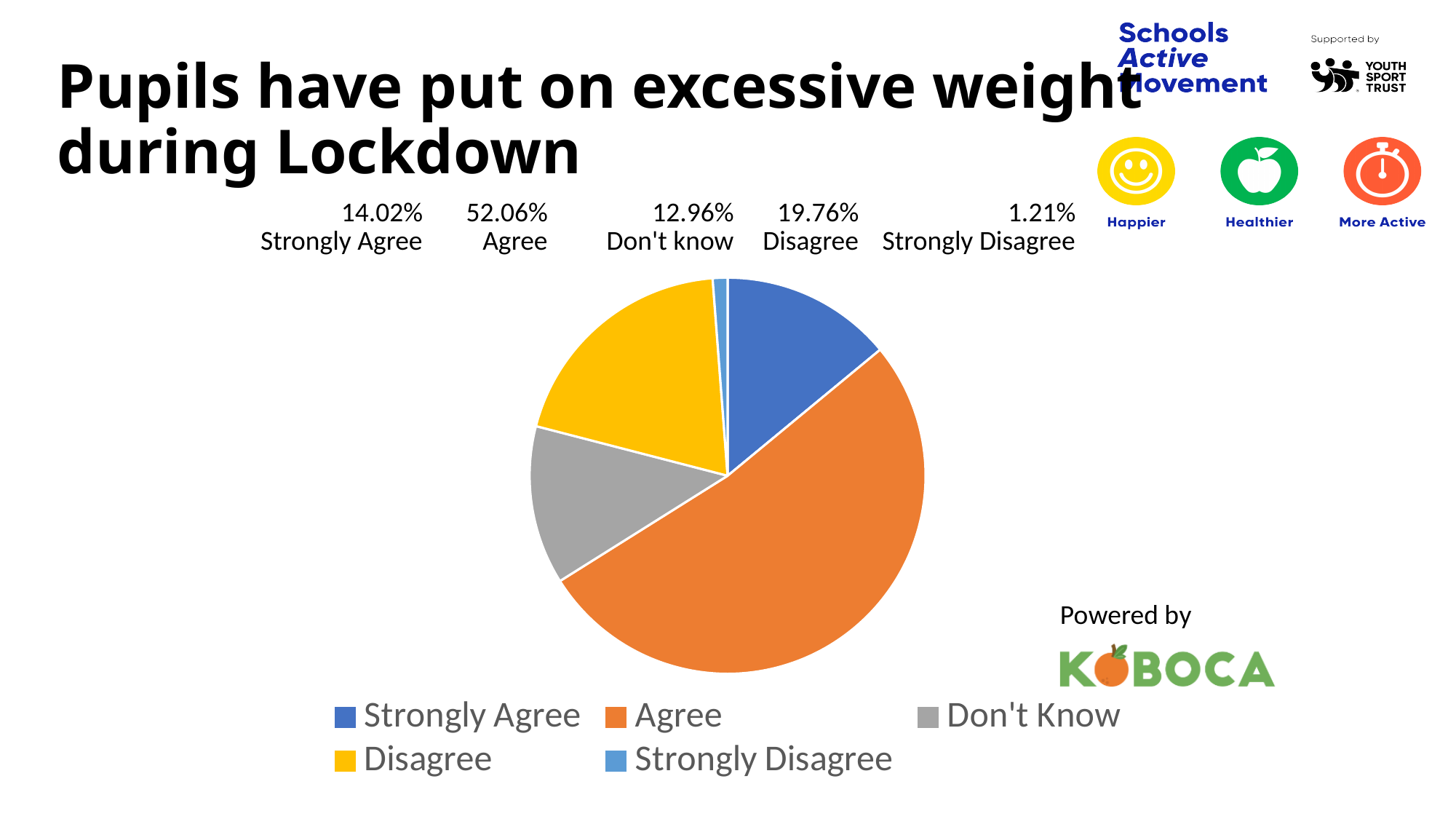
Which is larger, the share for Disagree or the share for Strongly Agree? Disagree How many slices does the pie chart have? 5 What percentage of respondents chose Strongly Disagree? 1.21% What percentage of respondents chose Disagree? 19.76% Which response has the smallest share of the pie? Strongly Disagree What percentage of respondents chose Strongly Agree? 14.02% What percentage of respondents chose Agree? 52.06% What is the combined percentage of Strongly Agree and Agree? 66.08% Which response has the largest share of the pie? Agree What is the difference in percentage points between Agree and Disagree? 32.30 What kind of chart is shown on the slide? Pie chart What colour is the Agree slice in the pie chart? Orange